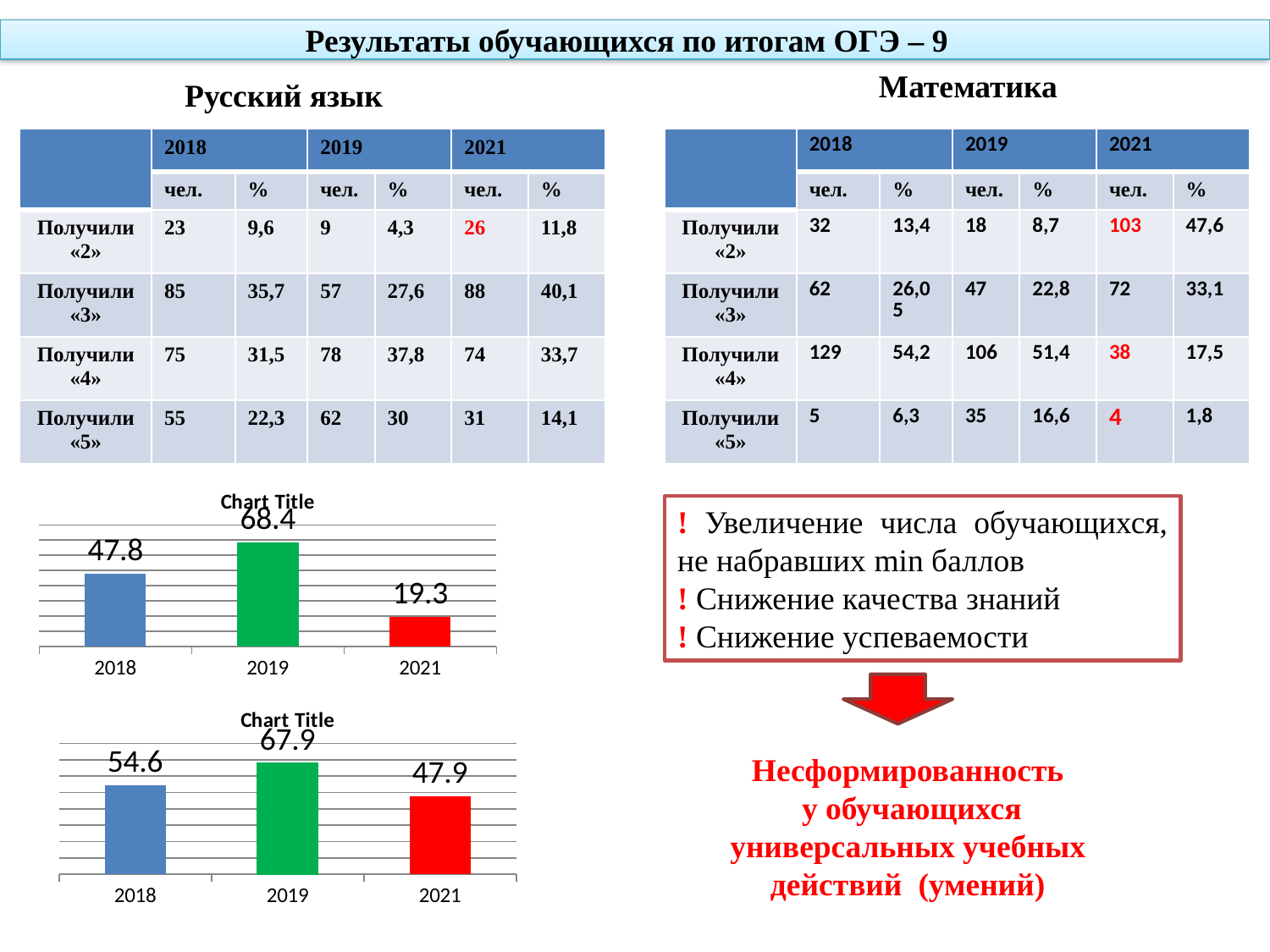
In the upper chart, what is the difference between the values for 2019 and 2021? 49.1 In the lower chart, what is the difference between the values for 2019 and 2018? 13.3 What type of chart is the lower chart? bar chart In the lower chart, what is the value for 2018? 54.6 In the upper chart, what is the value for 2019? 68.4 In the lower chart, which year has the lowest value? 2021 In the lower chart, what is the value for 2021? 47.9 How many bars are plotted in the upper chart? 3 In the upper chart, what is the value for 2021? 19.3 In the upper chart, which year has the lowest value? 2021 In the lower chart, which is larger, the value for 2018 or the value for 2021? 2018 In the upper chart, which year has the highest value? 2019